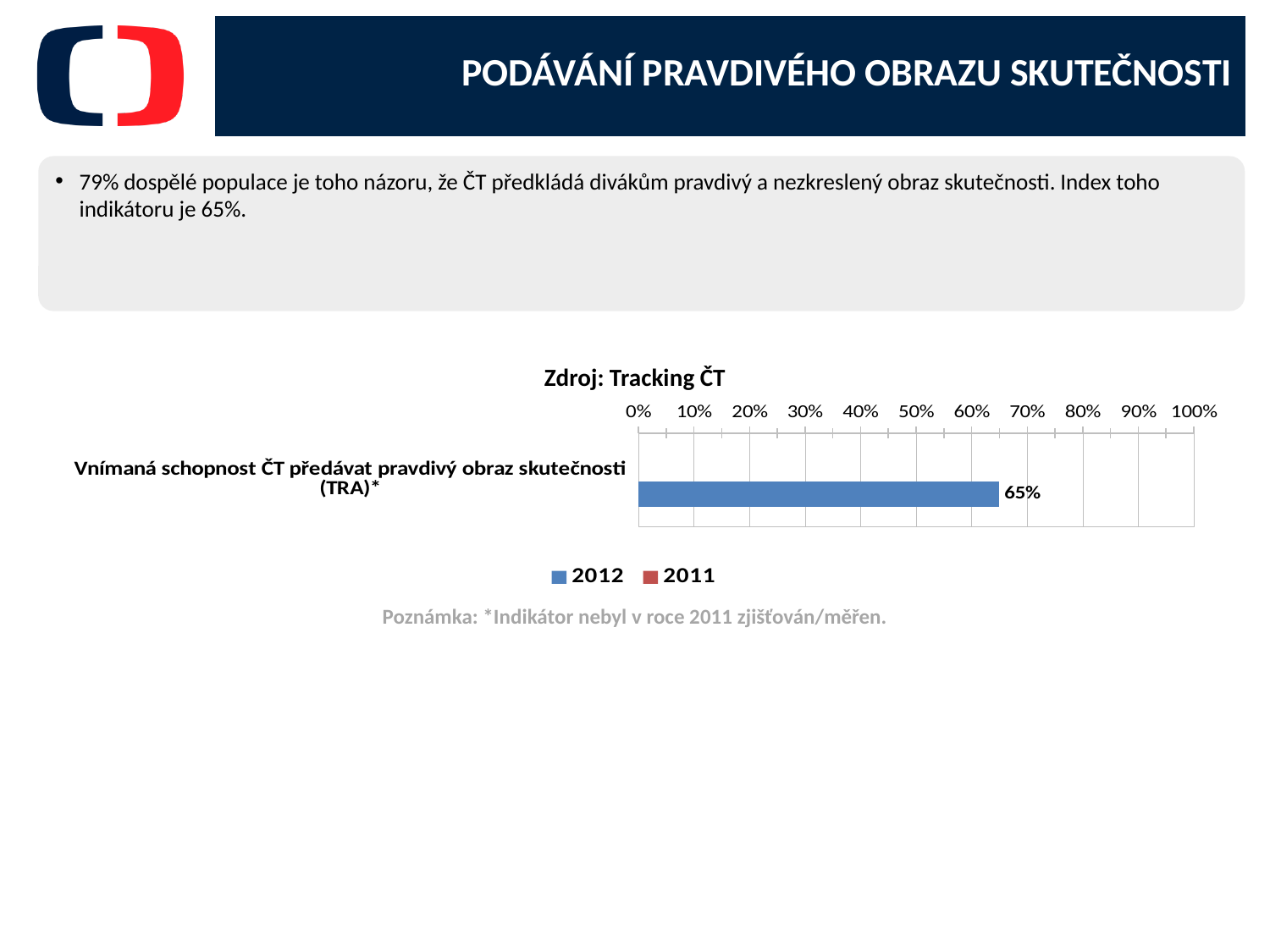
How many series does the chart legend list? 2 What is the maximum value shown on the chart's percentage axis? 100% What is the title of the chart? Zdroj: Tracking ČT How many categories are plotted on the chart? 1 Is the 2012 value for "Vnímaná schopnost ČT předávat pravdivý obraz skutečnosti (TRA)*" greater or less than 70%? less What is the value for 2012 for "Vnímaná schopnost ČT předávat pravdivý obraz skutečnosti (TRA)*"? 65% What kind of chart is shown on the slide? bar chart Which year's series has a bar plotted on the chart? 2012 Is the 2012 value for "Vnímaná schopnost ČT předávat pravdivý obraz skutečnosti (TRA)*" greater or less than 50%? greater Which series are listed in the chart legend? 2012 and 2011